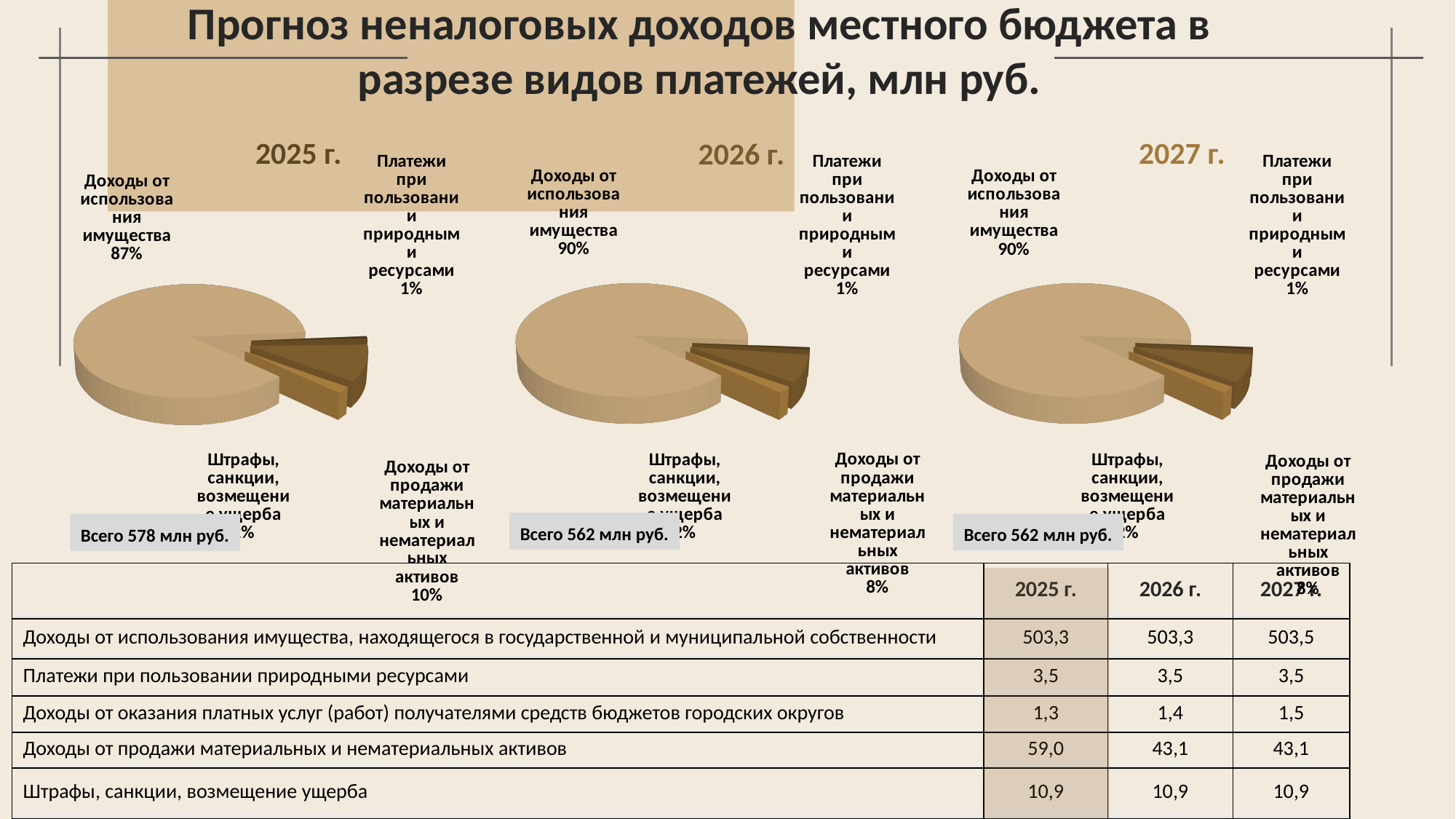
How many pie charts are shown on the slide? 3 What total (Всего) is shown under the 2026 г. pie chart? 562 млн руб. In the 2026 г. pie chart, what share is labelled for Доходы от использования имущества? 90% What kind of chart is used for the 2025 г. chart? pie chart In the 2026 г. pie chart, which slice is the largest? Доходы от использования имущества In the 2025 г. pie chart, what share is labelled for Доходы от продажи материальных и нематериальных активов? 10% In the 2027 г. pie chart, what share is labelled for Доходы от использования имущества? 90% What total (Всего) is shown under the 2025 г. pie chart? 578 млн руб.